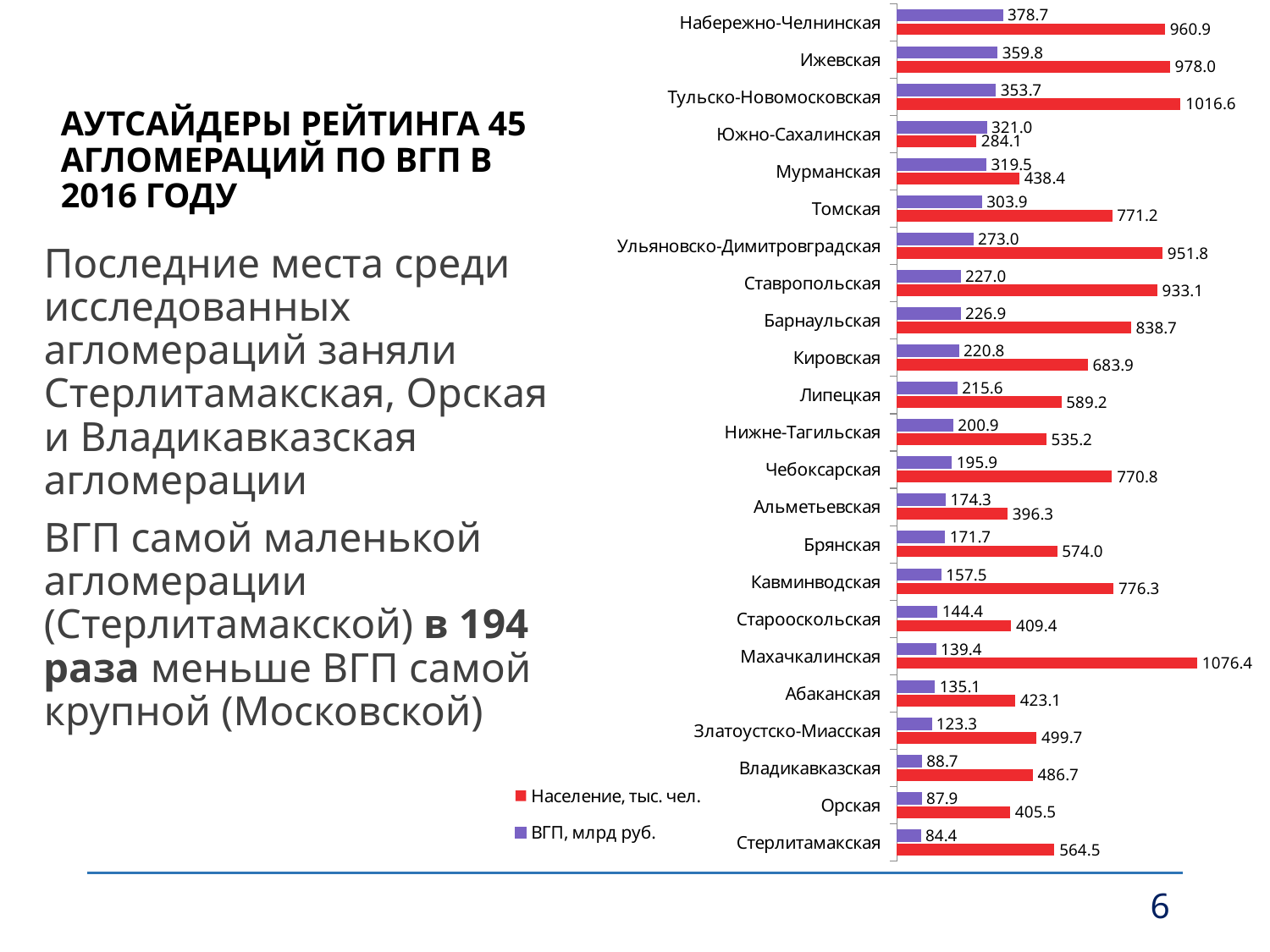
Which colour represents Население, тыс. чел. in the chart? Red How many agglomerations are shown in the chart? 23 What type of chart is shown on the slide? Bar chart Which agglomeration has the lowest ВГП, млрд руб. value? Стерлитамакская What is the difference between the Население, тыс. чел. values for Ижевская and Набережно-Челнинская? 17.1 How many series does the legend list? 2 Which agglomeration has the highest Население, тыс. чел. value? Махачкалинская What is the ВГП, млрд руб. value for Стерлитамакская? 84.4 Which is larger: the ВГП, млрд руб. value for Южно-Сахалинская or its Население, тыс. чел. value? ВГП, млрд руб. (321.0) Which agglomeration has the lowest Население, тыс. чел. value? Южно-Сахалинская What is the Население, тыс. чел. value for Махачкалинская? 1076.4 What is the Население, тыс. чел. value for Томская? 771.2